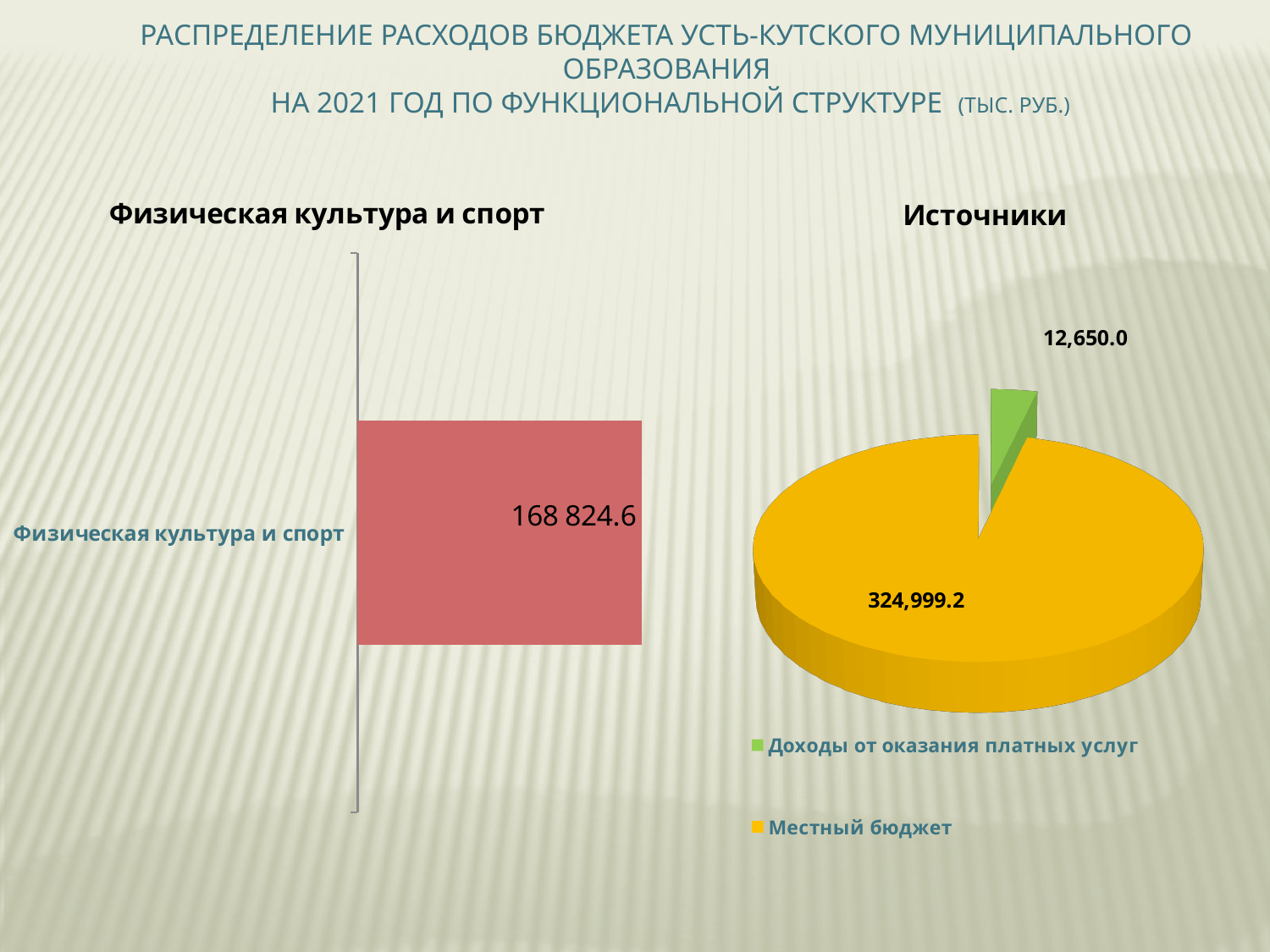
What kind of chart is the chart titled "Физическая культура и спорт" on the left of the slide? bar chart In the chart titled "Источники", which category has the largest slice? Местный бюджет In the chart titled "Источники", what colour is the slice for Местный бюджет? yellow In the chart titled "Источники", which category has the smallest slice? Доходы от оказания платных услуг What kind of chart is the chart titled "Источники" on the right of the slide? pie chart How many entries does the legend of the chart titled "Источники" list? 2 In the chart titled "Источники", what is the difference between the value for Местный бюджет and the value for Доходы от оказания платных услуг? 312,349.2 How many bars are plotted in the chart titled "Физическая культура и спорт"? 1 In the chart titled "Источники", what is the total of the two slices? 337,649.2 In the chart titled "Источники", what is the value for Местный бюджет? 324,999.2 In the chart titled "Физическая культура и спорт", what is the value of the bar for Физическая культура и спорт? 168 824.6 In the chart titled "Источники", what is the value for Доходы от оказания платных услуг? 12,650.0